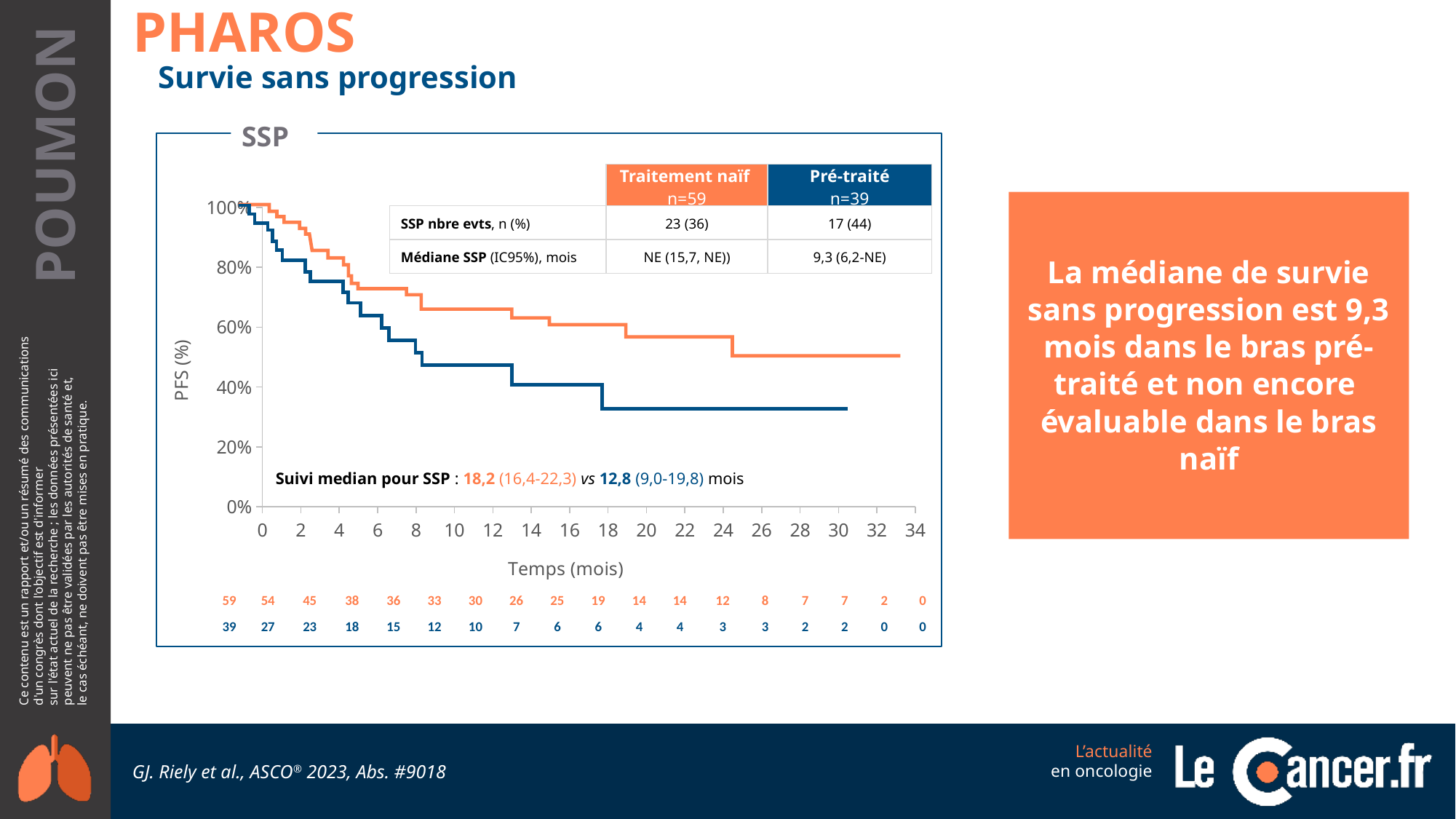
What is the difference in the number of patients at risk at 0 months between the Traitement naïf and Pré-traité arms? 20 What is the label of the x axis of the SSP chart? Temps (mois) What kind of chart is shown on the slide? line chart Which arm has the higher PFS at 24 months, Traitement naïf or Pré-traité? Traitement naïf What is the number of SSP events, n (%), in the Traitement naïf arm? 23 (36) What is the median SSP (IC95%) in months for the Traitement naïf arm? NE (15,7, NE)) What is the number of SSP events, n (%), in the Pré-traité arm? 17 (44) Is the PFS for the Pré-traité arm at 20 months greater or less than 40%? less How many patients are at risk at 18 months in the Traitement naïf arm? 19 How many series (treatment arms) are plotted on the SSP chart? 2 What is the median SSP (IC95%) in months for the Pré-traité arm? 9,3 (6,2-NE) How many patients are at risk at 12 months in the Pré-traité arm? 10